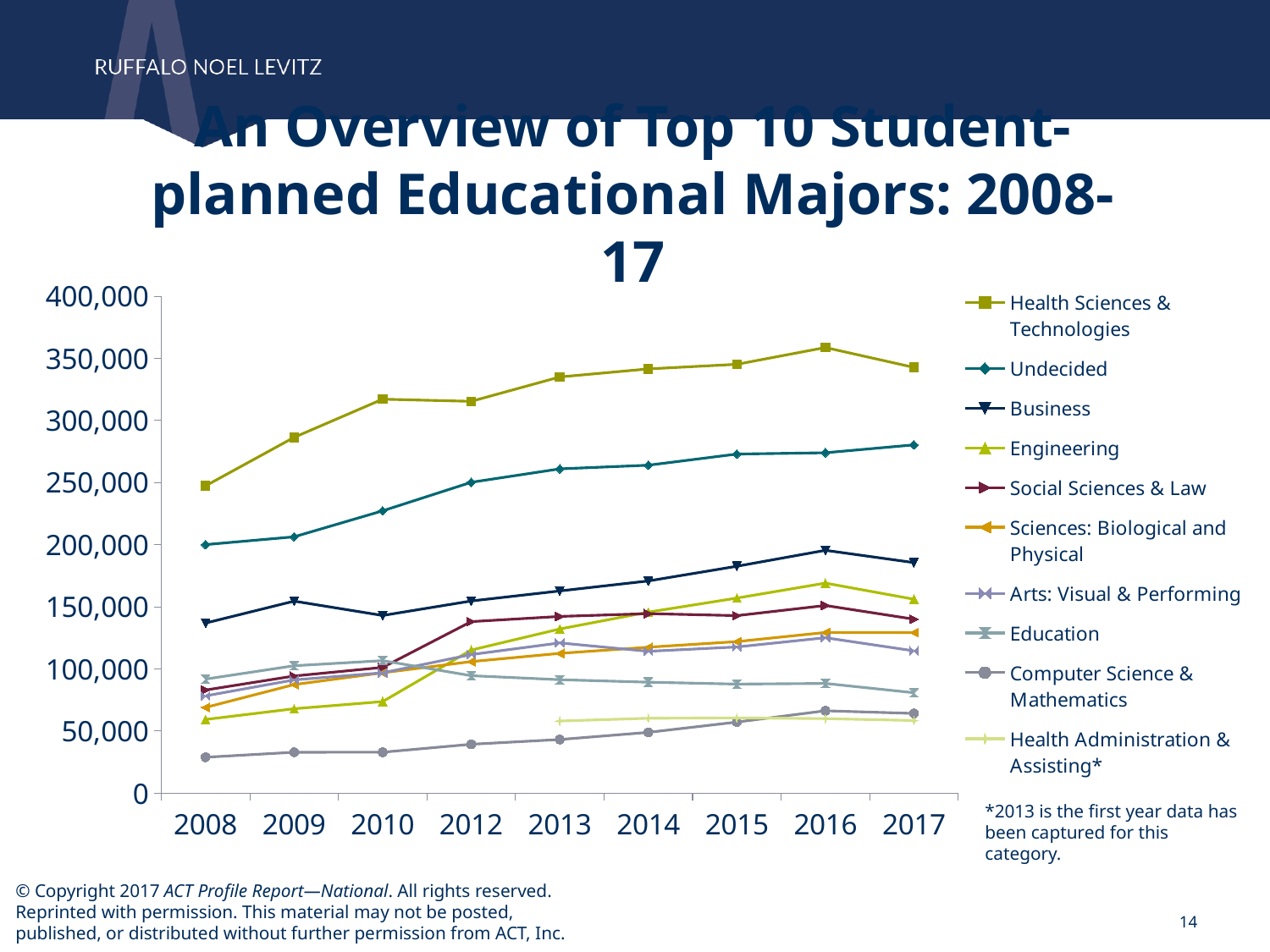
How many series does the legend list? 10 Is the value for Business in 2017 greater or less than 150,000? greater Which major has the lowest value in 2008? Computer Science & Mathematics Is the value for Computer Science & Mathematics in 2008 greater or less than 50,000? less Does the Undecided series rise or fall from 2008 to 2017? rise Does the Education series rise or fall from 2010 to 2017? fall Which major has the highest value in 2017? Health Sciences & Technologies What kind of chart is shown on the slide? line chart Is the value for Health Sciences & Technologies in 2010 greater or less than 300,000? greater In 2008, which is larger: Undecided or Business? Undecided How many years are shown along the x axis? 9